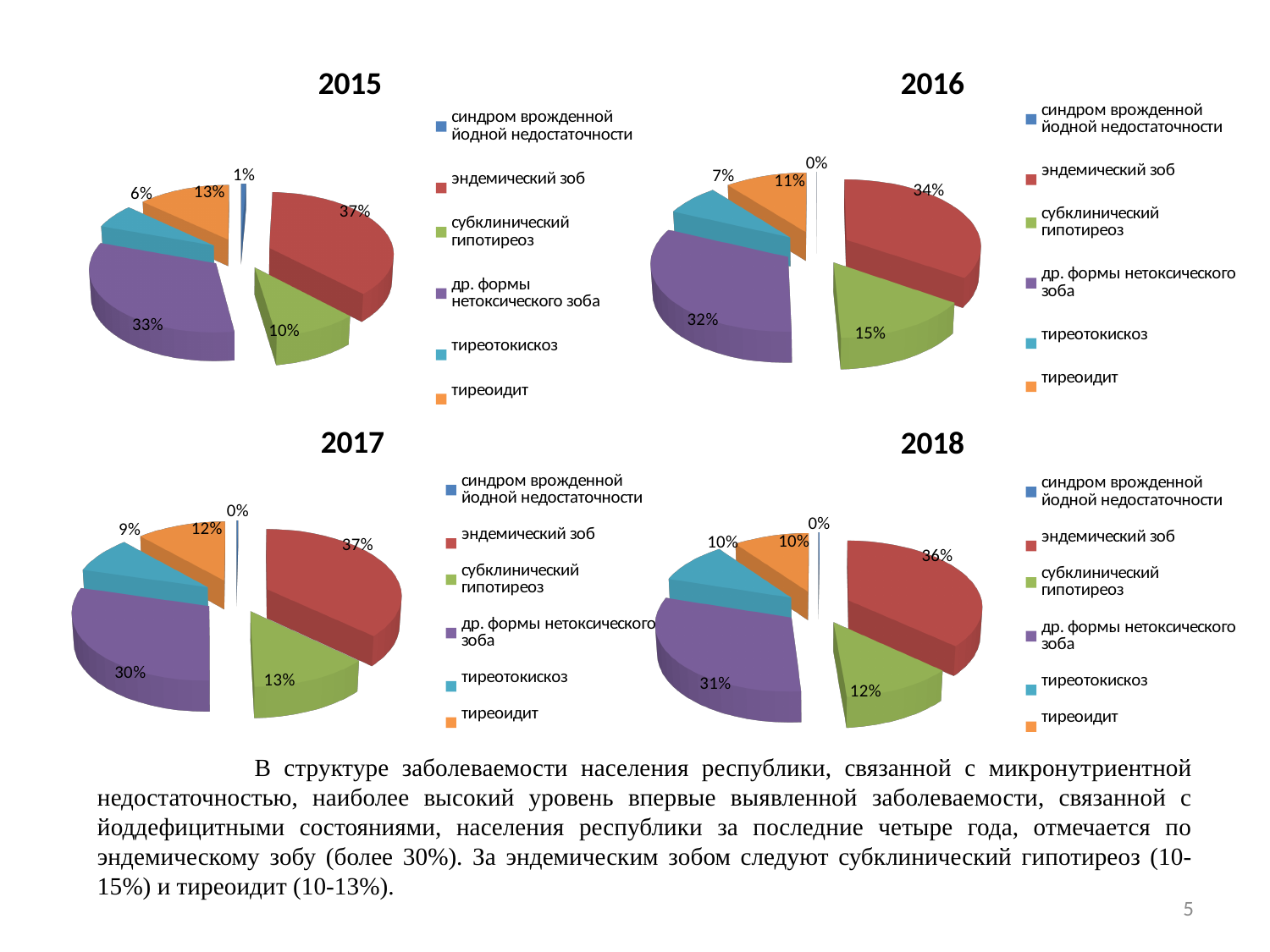
In the 2017 pie chart, what is the difference between the shares of эндемический зоб and др. формы нетоксического зоба? 7% In the 2016 pie chart, what share does субклинический гипотиреоз have? 15% How many pie charts are shown on the slide? 4 In the 2015 pie chart, what share does эндемический зоб have? 37% How many categories does the legend of the 2015 chart list? 6 In the 2016 pie chart, which category has the smallest share? синдром врожденной йодной недостаточности What type of chart is used for the 2016 data? pie chart In the 2017 pie chart, what share does тиреотокискоз have? 9% In the 2018 pie chart, what share does др. формы нетоксического зоба have? 31% In the 2015 pie chart, what share does тиреоидит have? 13% In the 2018 pie chart, which is larger: the share of субклинический гипотиреоз or the share of тиреоидит? субклинический гипотиреоз In the 2015 pie chart, which category has the largest share? эндемический зоб